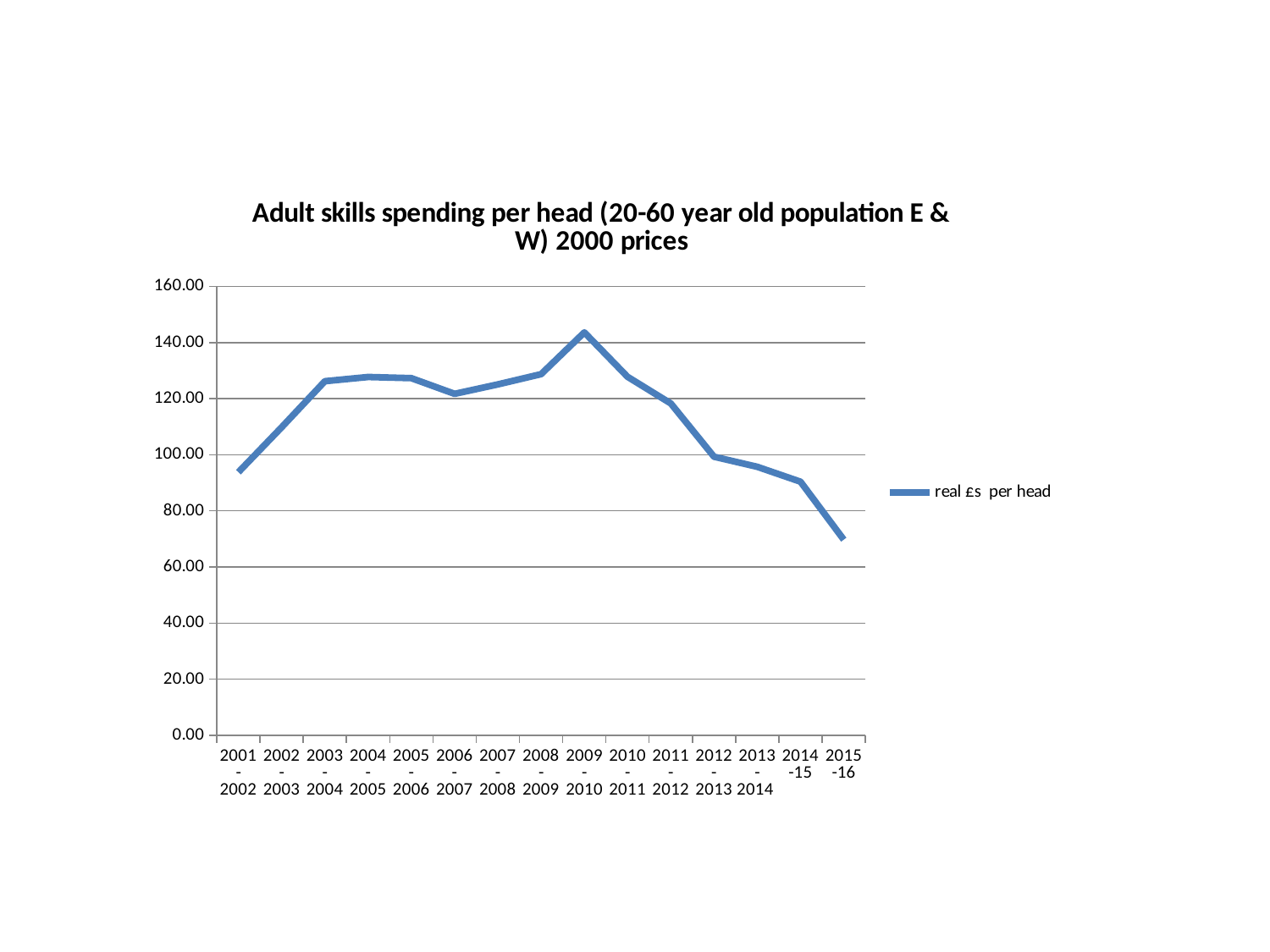
How many year categories are shown on the x axis? 15 What is the legend entry for the plotted series? real £s per head Is the value for 2009-2010 greater or less than 140? greater In which year is adult skills spending per head highest? 2009-2010 Is the value for 2015-16 greater or less than 80? less Which is larger, the value for 2003-2004 or the value for 2012-2013? 2003-2004 Is the value for 2001-2002 greater or less than 100? less In which year is adult skills spending per head lowest? 2015-16 Do the values rise or fall from 2009-2010 to 2015-16? fall How many series does the legend list? 1 What kind of chart is shown on the slide? line chart